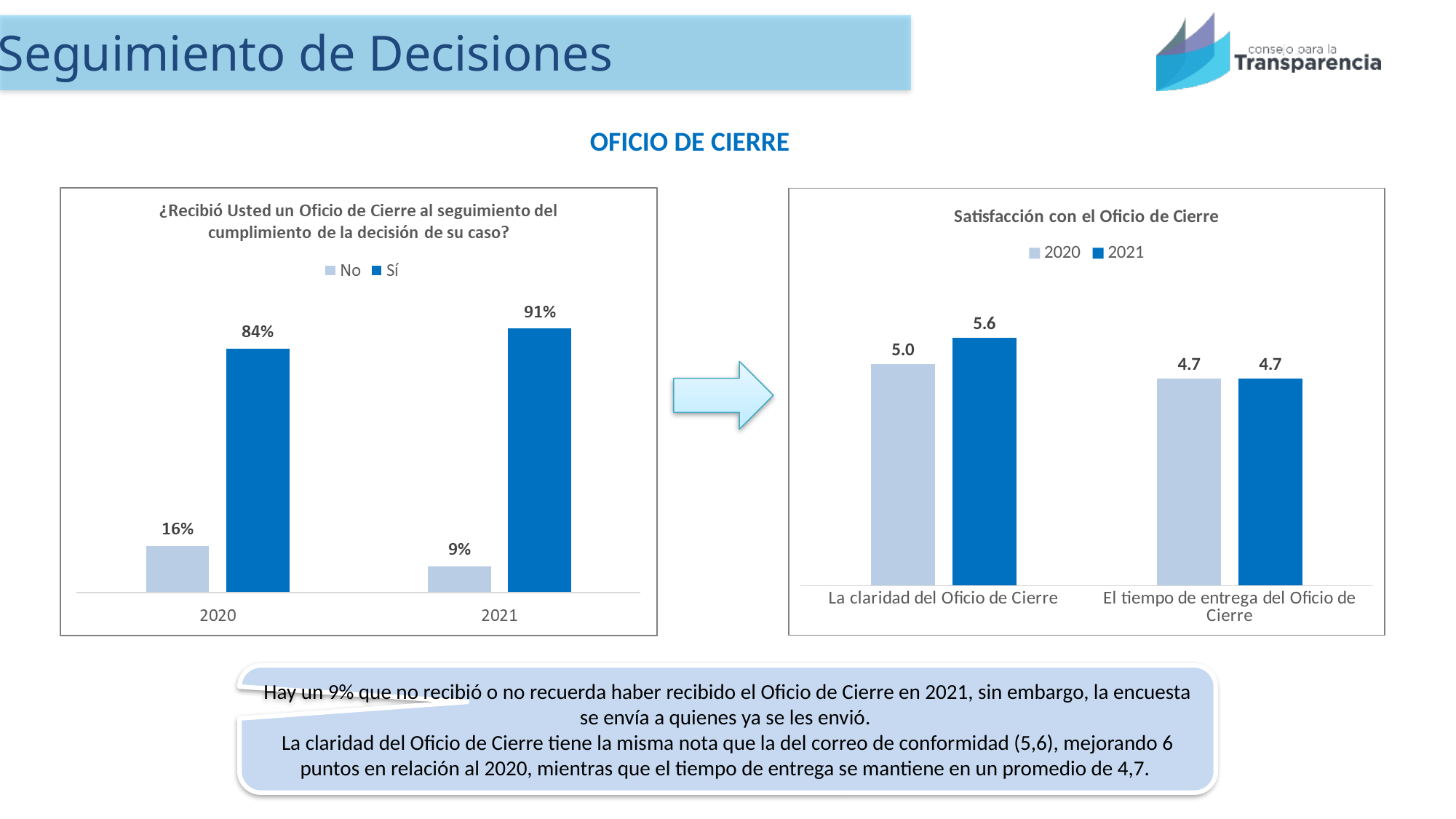
In the left chart (¿Recibió Usted un Oficio de Cierre...?), what is the difference between the Sí values for 2021 and 2020? 7% In the left chart (¿Recibió Usted un Oficio de Cierre...?), does the No value rise or fall from 2020 to 2021? fall In the right chart (Satisfacción con el Oficio de Cierre), what is the 2021 value for La claridad del Oficio de Cierre? 5.6 In the right chart (Satisfacción con el Oficio de Cierre), what is the difference between the 2021 and 2020 values for La claridad del Oficio de Cierre? 0.6 What kind of chart is the right chart (Satisfacción con el Oficio de Cierre)? bar chart In the left chart (¿Recibió Usted un Oficio de Cierre...?), what is the value for Sí in 2021? 91% In the right chart (Satisfacción con el Oficio de Cierre), what is the 2020 value for El tiempo de entrega del Oficio de Cierre? 4.7 In the left chart (¿Recibió Usted un Oficio de Cierre...?), how many series does the legend list? 2 In the right chart (Satisfacción con el Oficio de Cierre), how many categories are shown on the x axis? 2 In the left chart (¿Recibió Usted un Oficio de Cierre...?), which series is larger in 2020, No or Sí? Sí In the right chart (Satisfacción con el Oficio de Cierre), which bar has the highest value? La claridad del Oficio de Cierre, 2021 In the left chart (¿Recibió Usted un Oficio de Cierre...?), what is the value for No in 2020? 16%